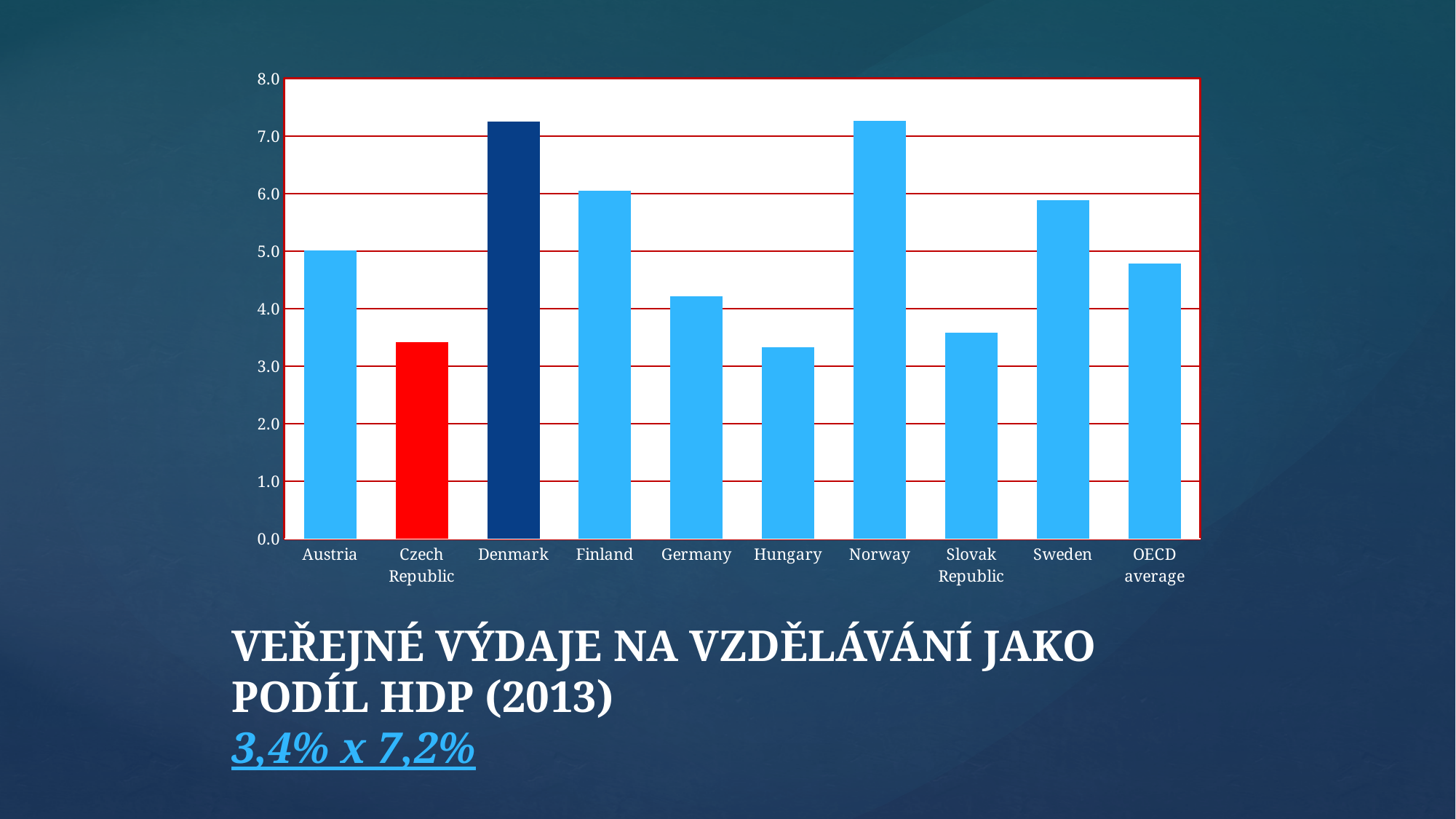
Which bar in the chart is coloured red? Czech Republic Is the value for Sweden greater or less than 6.0? less Which has the larger value, Sweden or Germany? Sweden Which bar in the chart is coloured dark blue? Denmark What kind of chart is shown on the slide? bar chart How many countries or categories are shown on the x axis of the chart? 10 Is the value for the OECD average greater or less than 5.0? less Which has the larger value, Denmark or the Czech Republic? Denmark Is the value for Germany greater or less than 4.0? greater